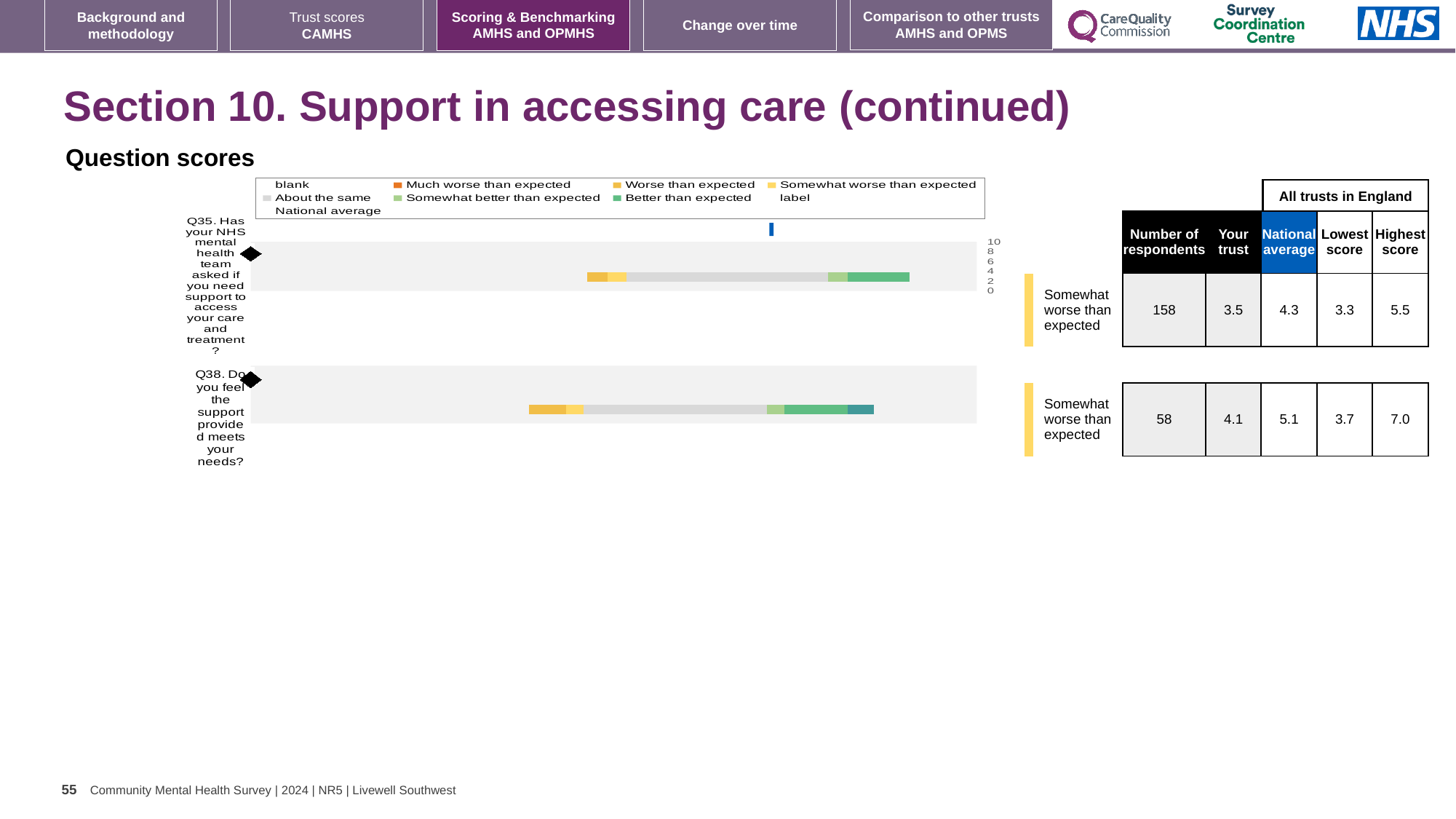
Which two questions are shown in the question scores chart? Q35 and Q38 What is the lowest score among all trusts in England for Q35? 3.3 What colour does the legend use for 'About the same'? Grey Which question has the larger highest score across all trusts in England, Q35 or Q38? Q38 What is the difference between the national average and the 'Your trust' score for Q35? 0.8 What is the 'Your trust' score for Q38? 4.1 What is the number of respondents for Q35? 158 What is the highest score among all trusts in England for Q38? 7.0 How many questions (categories) are plotted in the question scores chart? 2 What benchmark category is given for Q38? Somewhat worse than expected What is the national average score for Q35? 4.3 What kind of chart is used to show the question scores on this slide? Bar chart